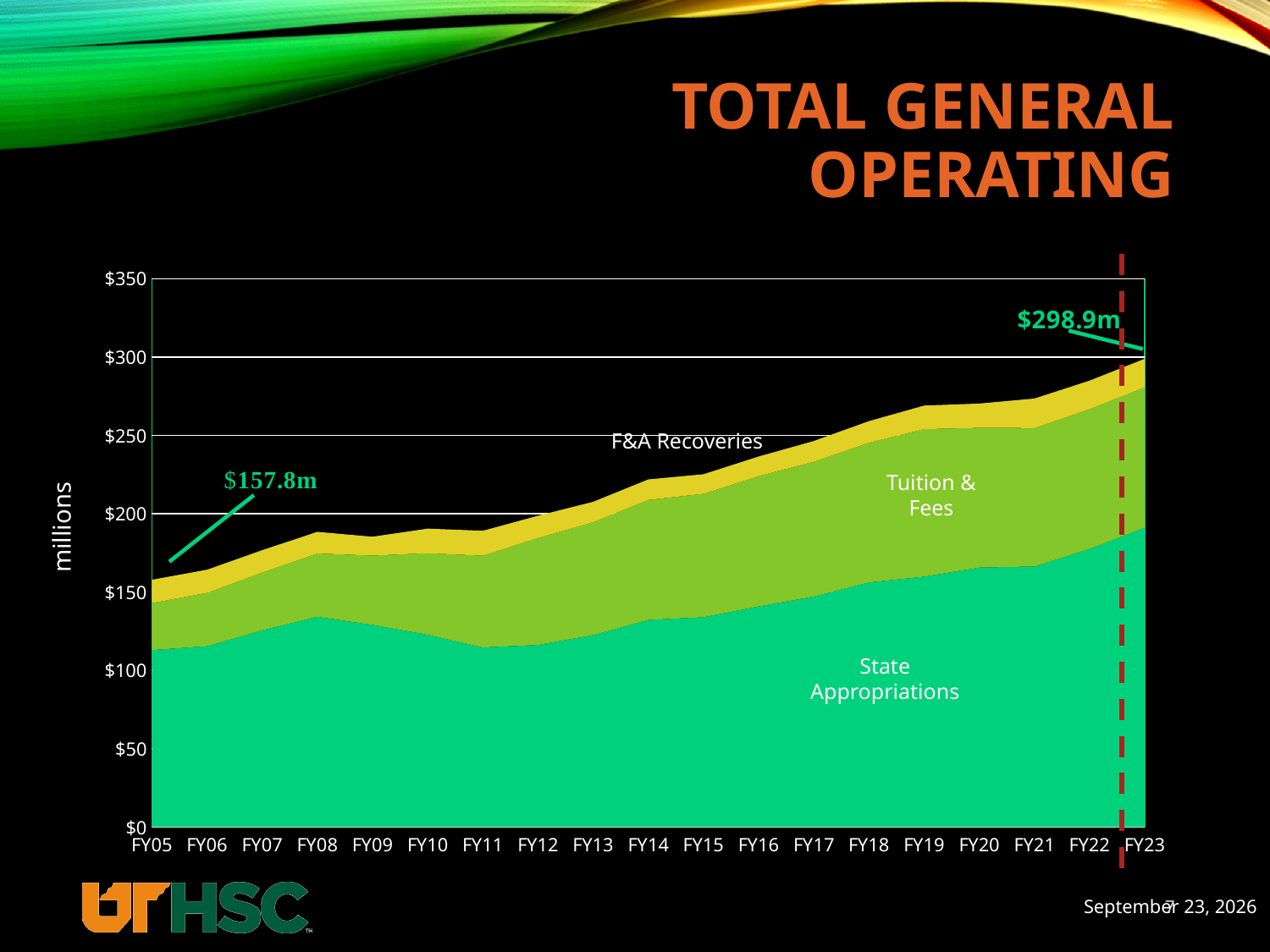
What is the difference between the labeled FY23 total and the labeled FY05 total? $141.1m Is the State Appropriations value for FY05 greater or less than $150? less Which fiscal year has the highest total general operating value? FY23 Is the total general operating value for FY23 greater or less than $250? greater How many fiscal years are shown on the x axis? 19 Does the total general operating value generally rise or fall from FY05 to FY23? rise Which is larger, the total for FY23 or the total for FY05? FY23 What kind of chart is shown on the slide? area chart What is the total general operating value labeled for FY05? $157.8m How many series are stacked in the chart? 3 Which fiscal year has the lowest total general operating value? FY05 What is the total general operating value labeled for FY23? $298.9m